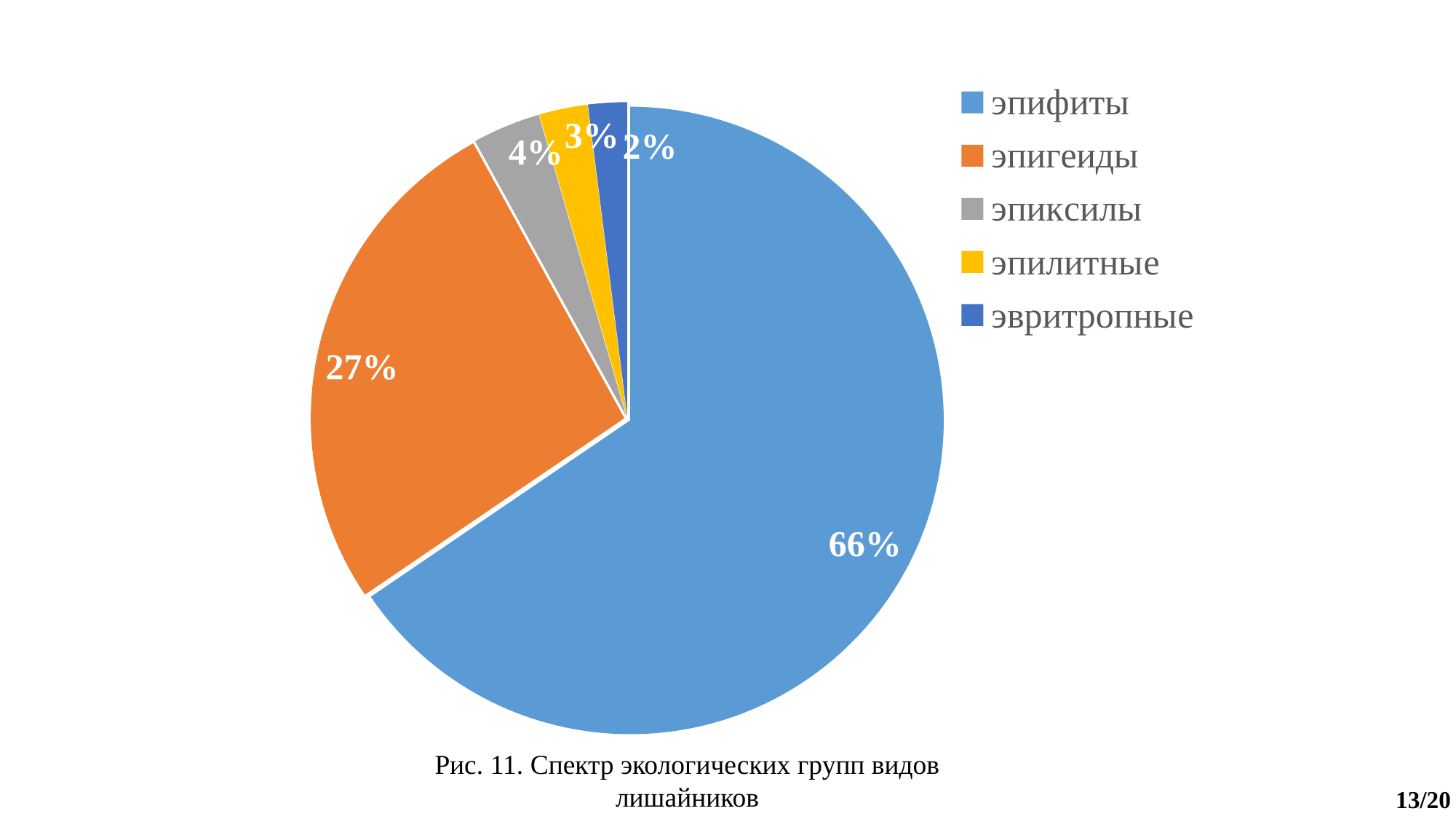
Which ecological group has the smallest slice of the pie? эвритропные Which ecological group has the largest slice of the pie? эпифиты What share of the pie does эпифиты take? 66% What kind of chart is shown on the slide? pie chart How many categories are shown in the pie chart? 5 What is the difference in percentage points between эпифиты and эпигеиды? 39 What share of the pie does эвритропные take? 2% What colour is the slice for эпигеиды? orange What share of the pie does эпиксилы take? 4% Which is larger, the share for эпиксилы or the share for эпилитные? эпиксилы